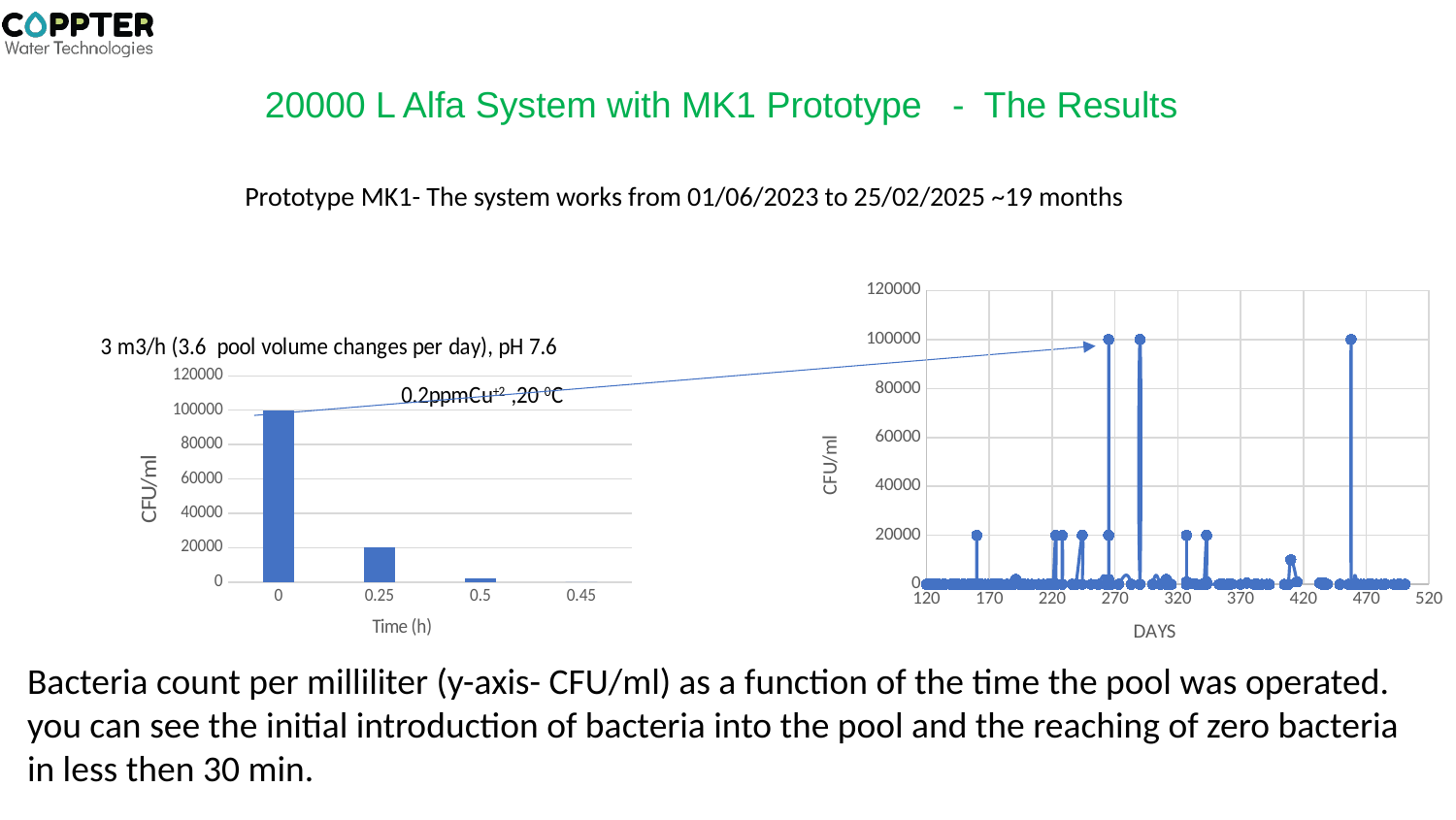
How many time categories are shown on the x axis of the left chart? 4 In the left chart, is the CFU/ml value at time 0.5 greater or less than 20000? less What is the x-axis title of the left chart? Time (h) In the left chart, what is the CFU/ml value at time 0.25? 20000 In the left chart, what is the CFU/ml value at time 0? 100000 In the left chart, which has the larger CFU/ml value: time 0 or time 0.25? 0 In the left chart, do the CFU/ml values rise or fall as time increases along the x axis? fall What kind of chart is the left chart (CFU/ml vs Time (h))? bar chart In the left chart, what is the difference in CFU/ml between time 0 and time 0.25? 80000 What is the x-axis title of the right chart? DAYS In the left chart, which time category has the highest CFU/ml value? 0 In the right chart, what is the highest CFU/ml value reached by any point? 100000